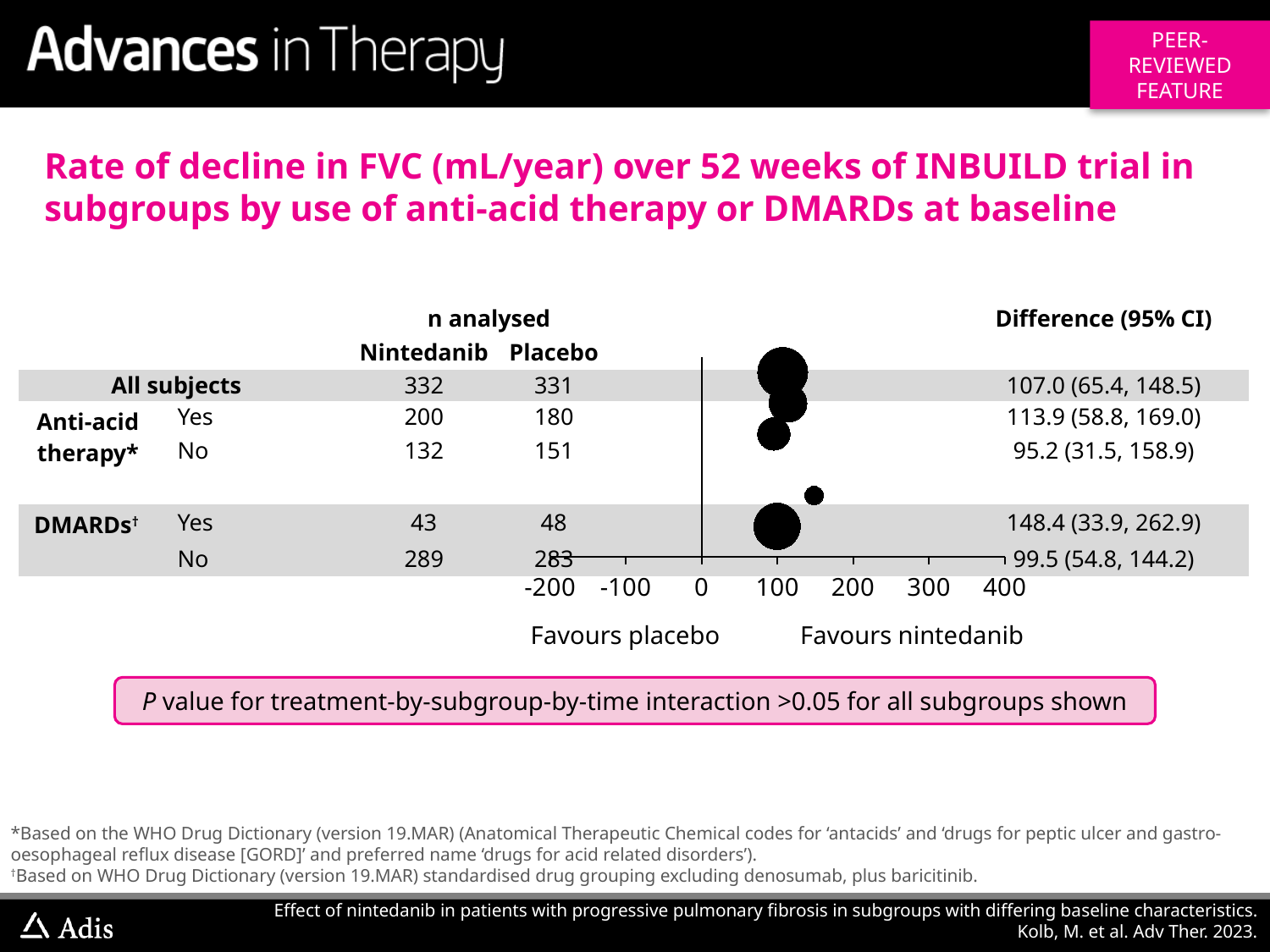
How many rows (all subjects plus subgroups) are plotted in the chart? 5 Which anti-acid therapy subgroup has the larger difference point estimate, Yes or No? Yes What label appears under the right-hand side of the x axis? Favours nintedanib Which subgroup has the largest point estimate for the difference? DMARDs Yes How many patients were analysed in the nintedanib group among those using anti-acid therapy at baseline (Yes)? 200 Is the difference point estimate for the DMARDs 'Yes' subgroup greater or less than 100? greater What is the difference (95% CI) shown for all subjects? 107.0 (65.4, 148.5) How many more patients were analysed in the nintedanib group than in the placebo group for all subjects? 1 How many patients were analysed in the placebo group among those not using DMARDs at baseline (No)? 283 What is the 95% CI for the difference in the DMARDs 'No' subgroup? (54.8, 144.2) Which subgroup has the smallest point estimate for the difference? Anti-acid therapy No What kind of chart is shown on the slide? Forest plot